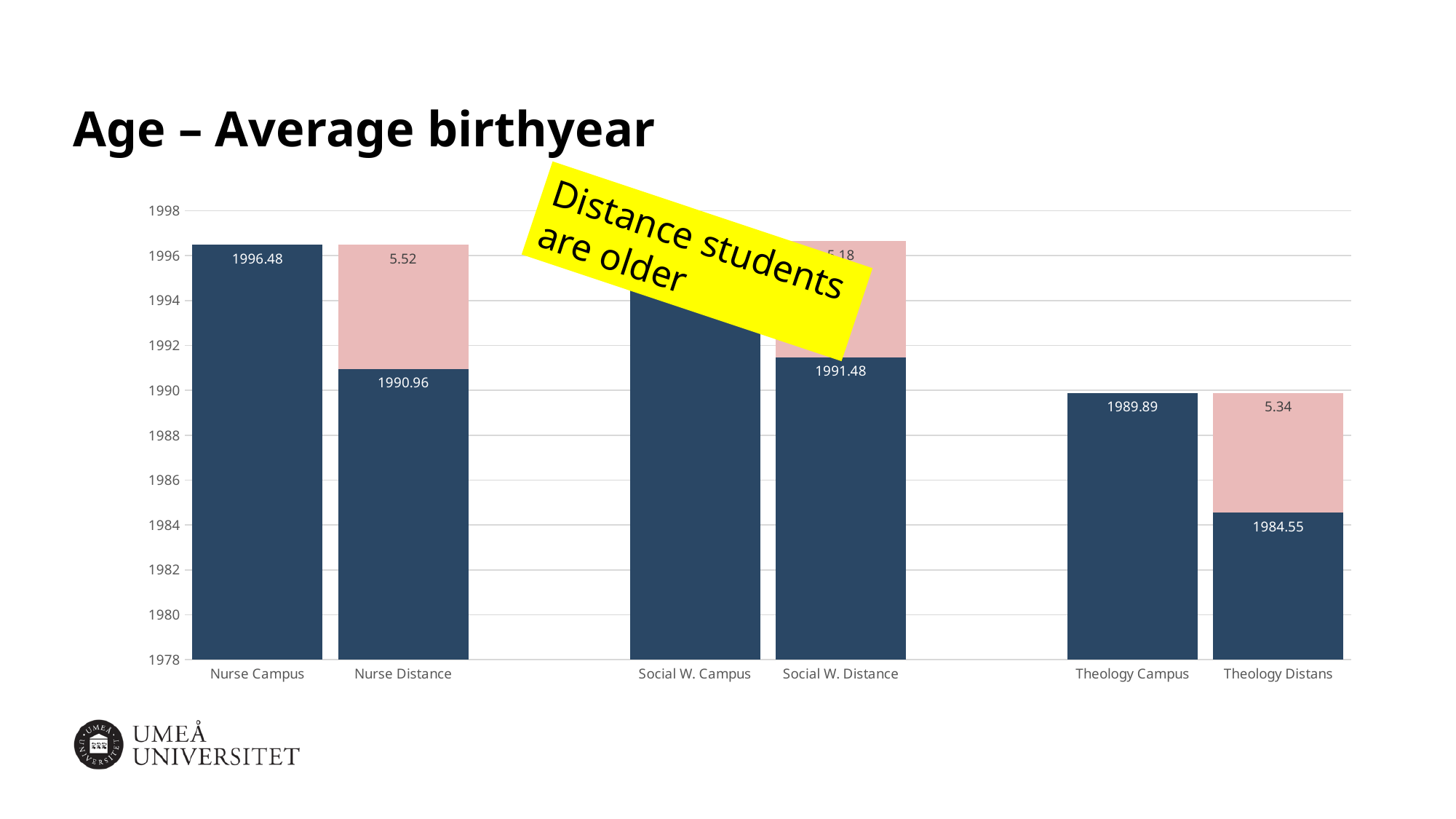
What value is labelled on the dark blue segment of the Social W. Distance bar? 1991.48 Which is larger, the value for Nurse Campus or the value for Theology Campus? Nurse Campus What value is labelled on the pink segment of the Nurse Distance bar? 5.52 What value is labelled on the dark blue segment of the Nurse Distance bar? 1990.96 How many categories are shown on the x axis of the chart? 6 Is the value for Social W. Campus greater or less than 1992? greater What value is labelled on the dark blue segment of the Theology Distans bar? 1984.55 What is the average birthyear shown for Nurse Campus? 1996.48 What kind of chart is shown on the slide? bar chart What is the average birthyear shown for Theology Campus? 1989.89 What is the difference between the Nurse Campus value (1996.48) and the dark blue segment of Nurse Distance (1990.96)? 5.52 What value is labelled on the pink segment of the Theology Distans bar? 5.34